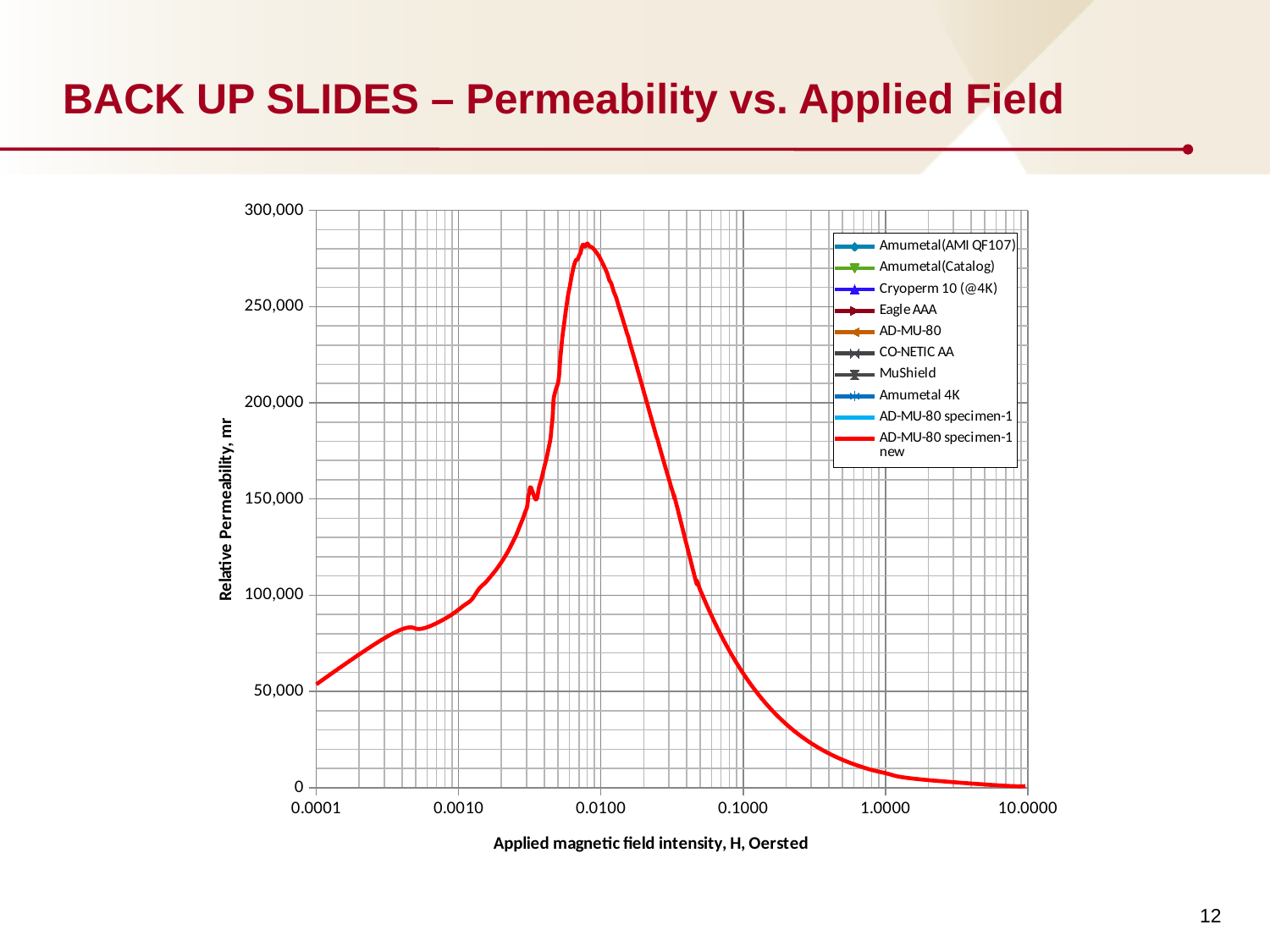
Is the value of the red curve at an applied field of 0.0001 Oersted greater or less than 50,000? greater Is the peak value of the red AD-MU-80 specimen-1 new curve greater or less than 250,000? greater What kind of chart is shown on the slide? Line chart How many series does the legend list? 10 Is the value of the red curve at an applied field of 1.0000 Oersted greater or less than 50,000? less Does the red curve rise or fall as the applied field increases from 0.0001 to 0.0010 Oersted? rise Does the red curve rise or fall as the applied field increases from 0.0100 to 10.0000 Oersted? fall What is the title of the y axis? Relative Permeability, mr Which of the two is larger for the red curve: the value at 0.0010 Oersted or the value at 0.1000 Oersted? 0.0010 Oersted What is the title of the x axis? Applied magnetic field intensity, H, Oersted